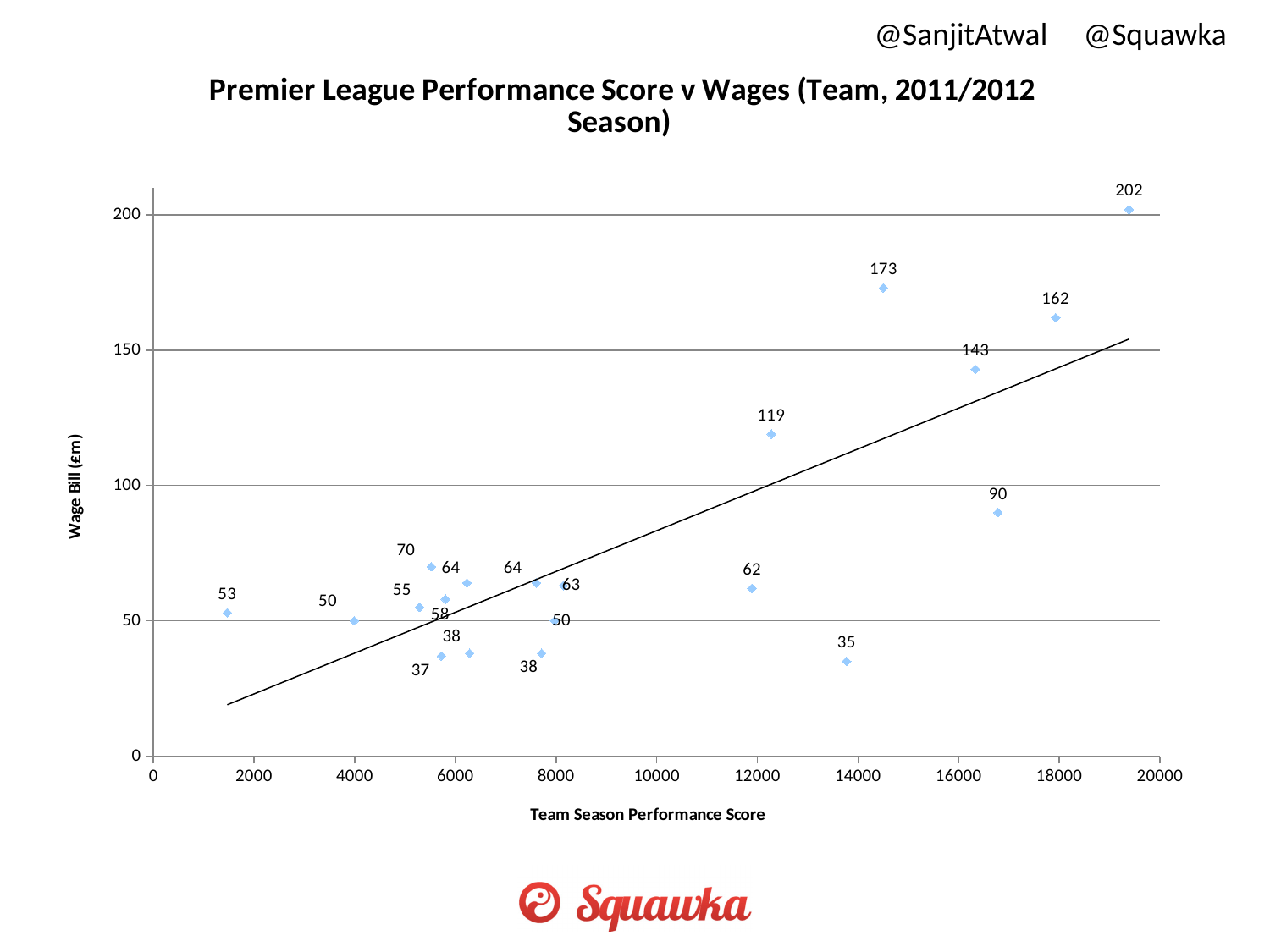
How many data points are plotted on the chart? 20 Which is larger, the labelled value 173 or the labelled value 162? 173 What is the difference between the highest and lowest labelled wage bill values? 167 What is the title of the chart? Premier League Performance Score v Wages (Team, 2011/2012 Season) What is the wage bill of the point with the highest Team Season Performance Score? 202 What is the highest wage bill value labelled on the chart? 202 Do wage bills generally rise or fall as the Team Season Performance Score increases? rise What is the label of the vertical axis? Wage Bill (£m) What is the lowest wage bill value labelled on the chart? 35 What kind of chart is shown on the slide? scatter chart What is the wage bill of the point with the lowest Team Season Performance Score? 53 How many points have a labelled wage bill greater than 100? 5